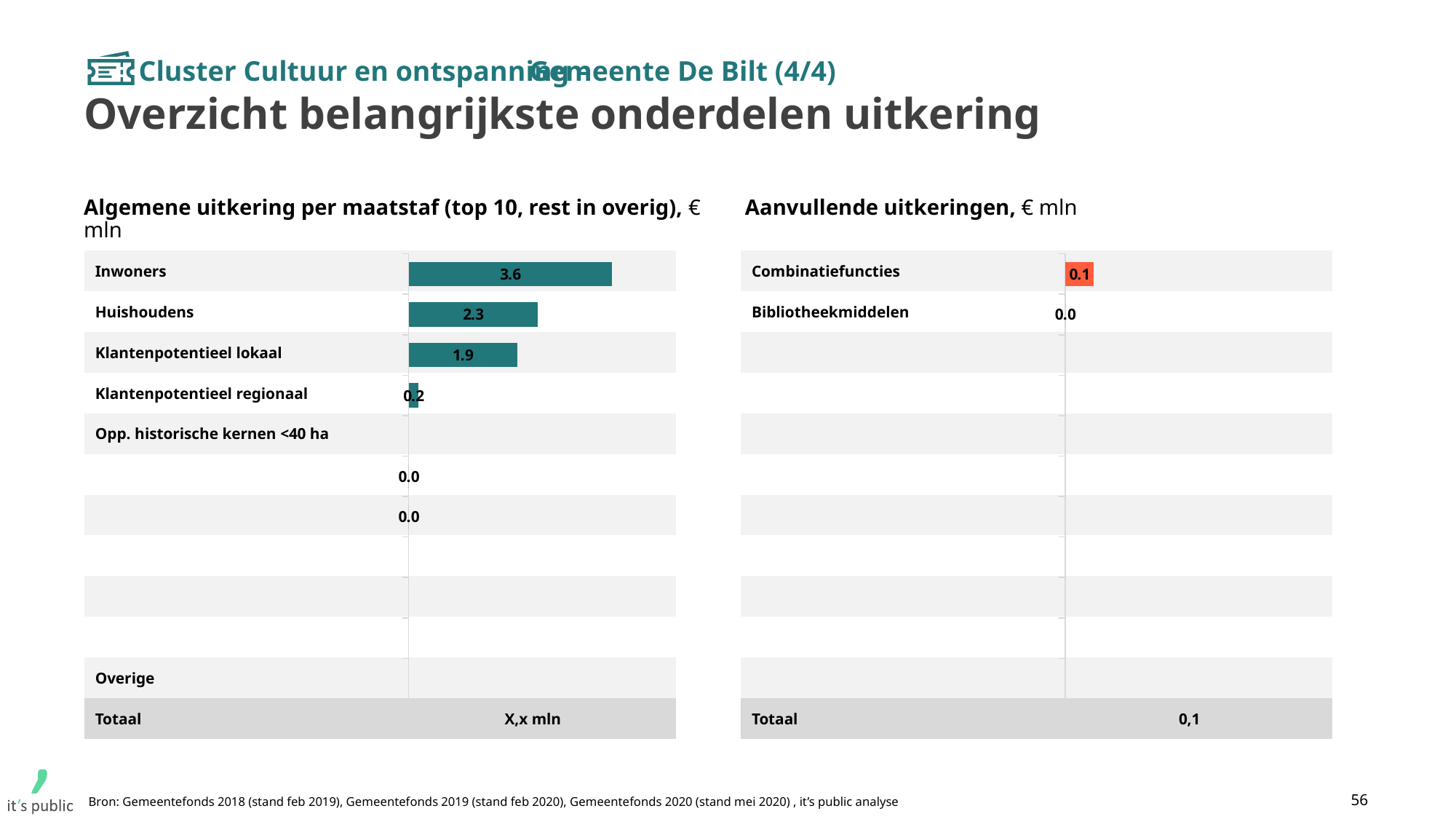
In the chart 'Algemene uitkering per maatstaf', what is the difference between the values for Inwoners and Huishoudens? 1.3 In the chart 'Algemene uitkering per maatstaf', what is the value for Inwoners? 3.6 In the chart 'Aanvullende uitkeringen', what is the value for Combinatiefuncties? 0.1 In the chart 'Algemene uitkering per maatstaf', which category has the highest value? Inwoners In the chart 'Algemene uitkering per maatstaf', what is the value for Klantenpotentieel regionaal? 0.2 What kind of chart is the 'Algemene uitkering per maatstaf' chart? bar chart In the chart 'Algemene uitkering per maatstaf', what is the value for Huishoudens? 2.3 In the chart 'Aanvullende uitkeringen', what is the value for Bibliotheekmiddelen? 0.0 In the chart 'Algemene uitkering per maatstaf', what is the value for Klantenpotentieel lokaal? 1.9 In the chart 'Algemene uitkering per maatstaf', which is larger: Huishoudens or Klantenpotentieel lokaal? Huishoudens In what unit are the values in the 'Aanvullende uitkeringen' chart expressed, according to its title? € mln In the chart 'Aanvullende uitkeringen', what is the Totaal shown at the bottom? 0,1